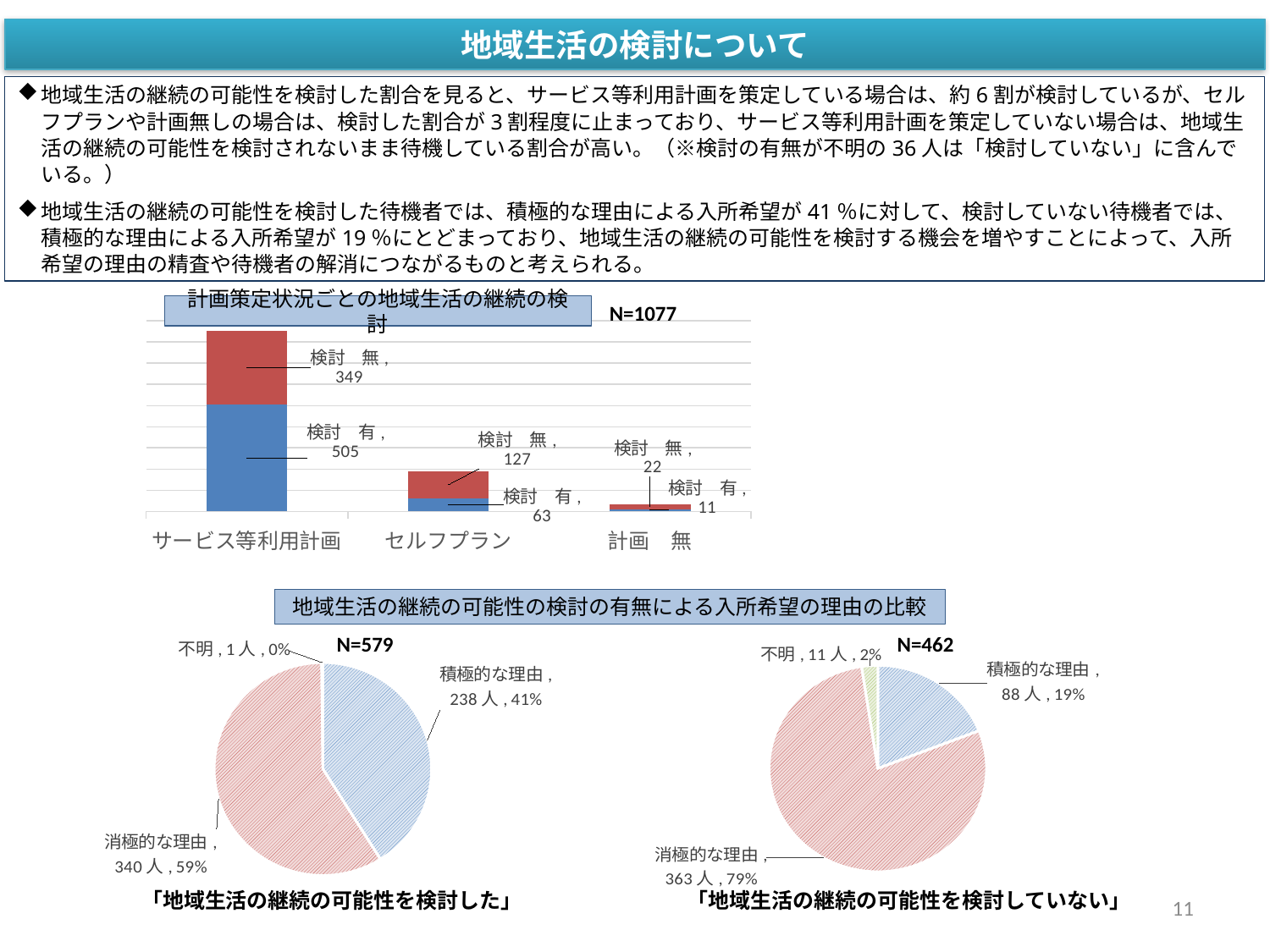
「計画策定状況ごとの地域生活の継続の検討」のグラフはどの種類のグラフですか？ 積み上げ棒グラフ 「地域生活の継続の可能性を検討していない」の円グラフで、消極的な理由の人数は何人ですか？ 363人 「地域生活の継続の可能性を検討していない」の円グラフで、不明の割合は何％ですか？ 2% 「計画策定状況ごとの地域生活の継続の検討」のグラフで、セルフプランの「検討 無」の値はいくつですか？ 127 「計画策定状況ごとの地域生活の継続の検討」のグラフで、サービス等利用計画の「検討 有」の値はいくつですか？ 505 「計画策定状況ごとの地域生活の継続の検討」のグラフで、サービス等利用計画の「検討 有」と「検討 無」の差はいくつですか？ 156 「計画策定状況ごとの地域生活の継続の検討」のグラフで、計画無の「検討 有」と「検討 無」の合計はいくつですか？ 33 「計画策定状況ごとの地域生活の継続の検討」のグラフで、「検討 無」の値が最も小さいカテゴリはどれですか？ 計画 無 「地域生活の継続の可能性を検討した」の円グラフのNはいくつですか？ N=579 「地域生活の継続の可能性を検討した」の円グラフで、積極的な理由の割合は何％ですか？ 41% 「計画策定状況ごとの地域生活の継続の検討」のグラフには、いくつのカテゴリがありますか？ 3 「計画策定状況ごとの地域生活の継続の検討」のグラフで、「検討 有」の値が最も大きいカテゴリはどれですか？ サービス等利用計画